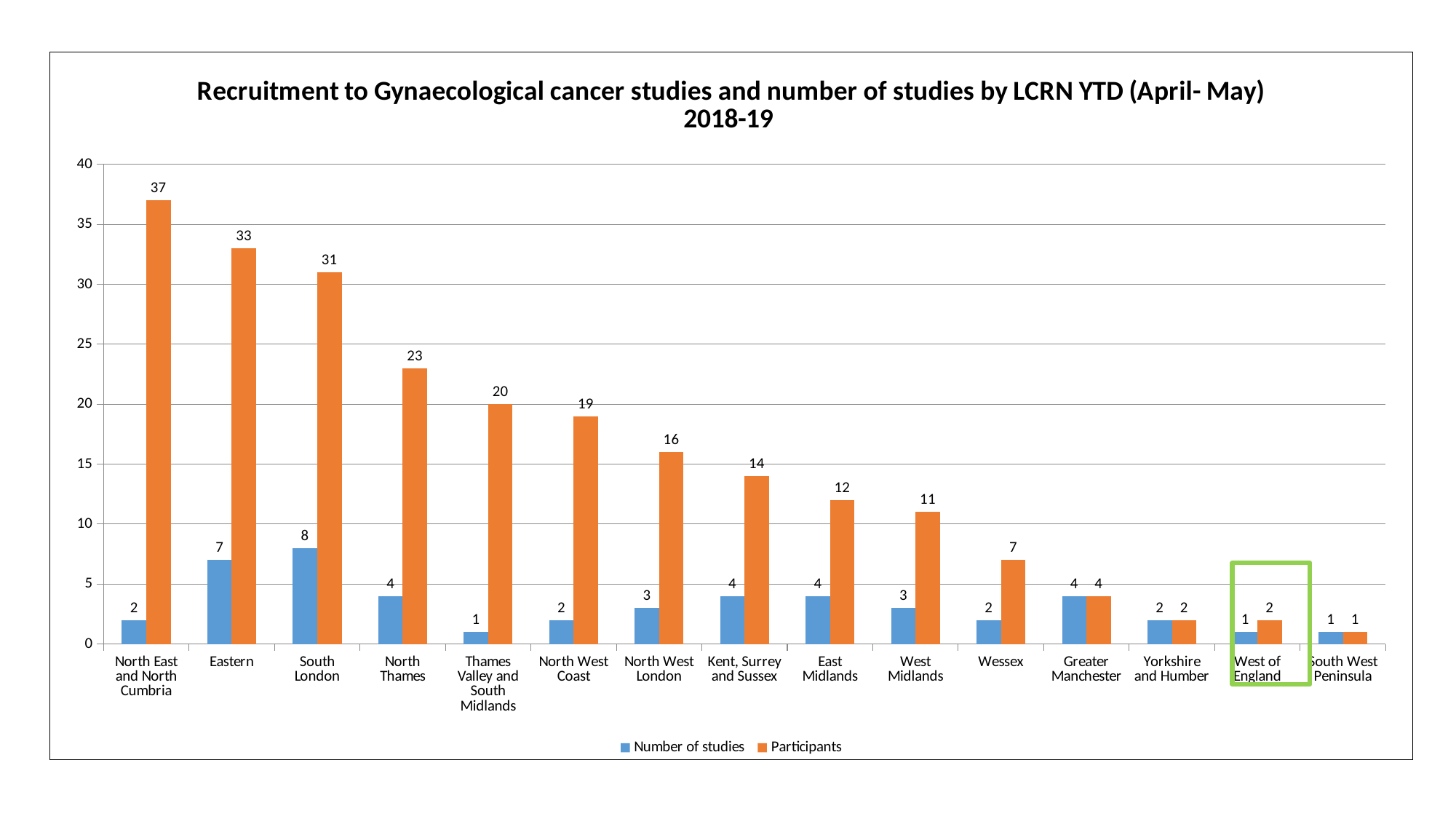
What kind of chart is shown on the slide? Bar chart Which LCRN has the highest number of Participants? North East and North Cumbria Which LCRN has the highest Number of studies? South London How many Participants are shown for North East and North Cumbria? 37 Which LCRN has the lowest number of Participants? South West Peninsula How many Participants are shown for Wessex? 7 What is the difference in Participants between Eastern and North Thames? 10 Which LCRN is highlighted with a green box on the chart? West of England How many series does the legend list? 2 What is the Number of studies for South London? 8 How many LCRN categories are shown on the x axis? 15 Which has more Participants, North West Coast or North West London? North West Coast